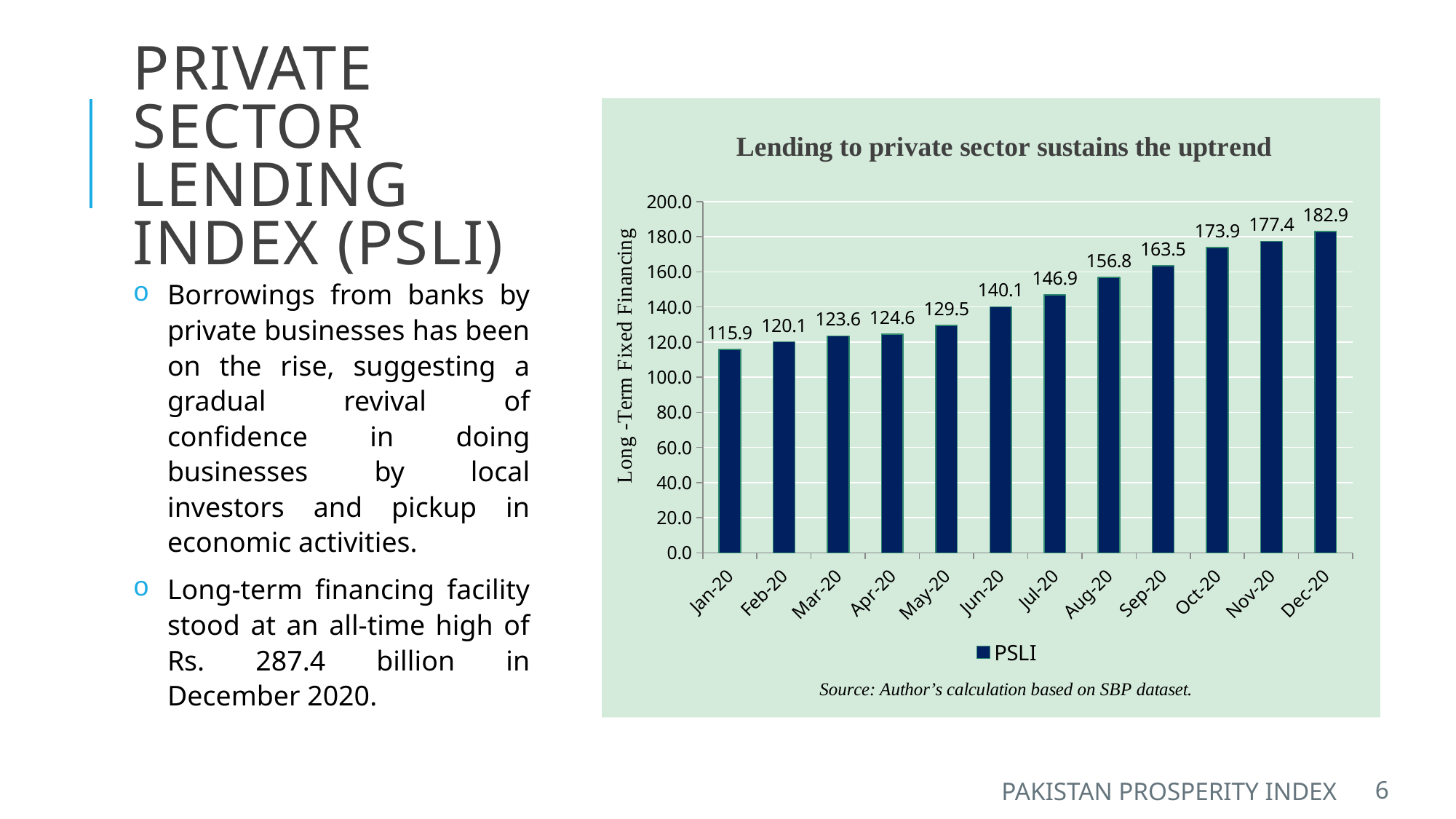
What kind of chart is shown on the slide? Bar chart Do the PSLI values rise or fall from Jan-20 to Dec-20? Rise How many months are shown on the x axis? 12 Which month has the lowest PSLI value? Jan-20 What is the PSLI value for Jan-20? 115.9 What is the difference between the PSLI values for Sep-20 and Aug-20? 6.7 What is the PSLI value for Oct-20? 173.9 What is the difference between the PSLI values for Dec-20 and Jan-20? 67.0 What is the PSLI value for Jul-20? 146.9 Which is larger, the PSLI value for Jun-20 or for May-20? Jun-20 Is the PSLI value for Nov-20 greater or less than 160.0? greater Which month has the highest PSLI value? Dec-20